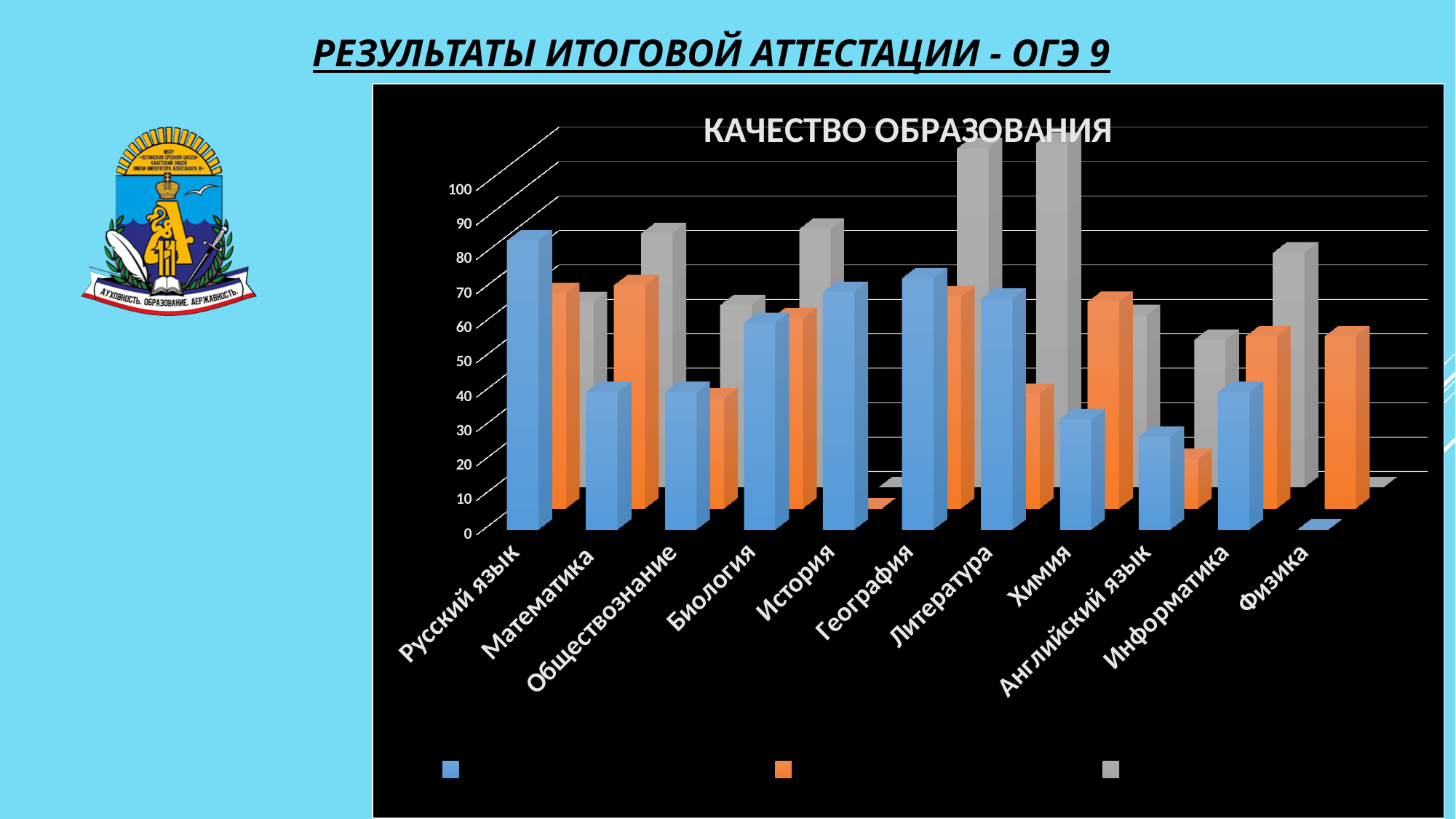
How many subject categories are shown on the x axis of the chart? 11 Is the value of the blue series for Физика greater or less than 10? less Is the value of the orange series for История greater or less than 10? less How many series does the chart's legend list? 3 Is the value of the gray series for Литература greater or less than 80? greater What is the title of the chart? КАЧЕСТВО ОБРАЗОВАНИЯ What kind of chart is shown on the slide? bar chart Which subject has the highest value in the blue series? Русский язык In the blue series, which is larger: the value for Русский язык or the value for Английский язык? Русский язык